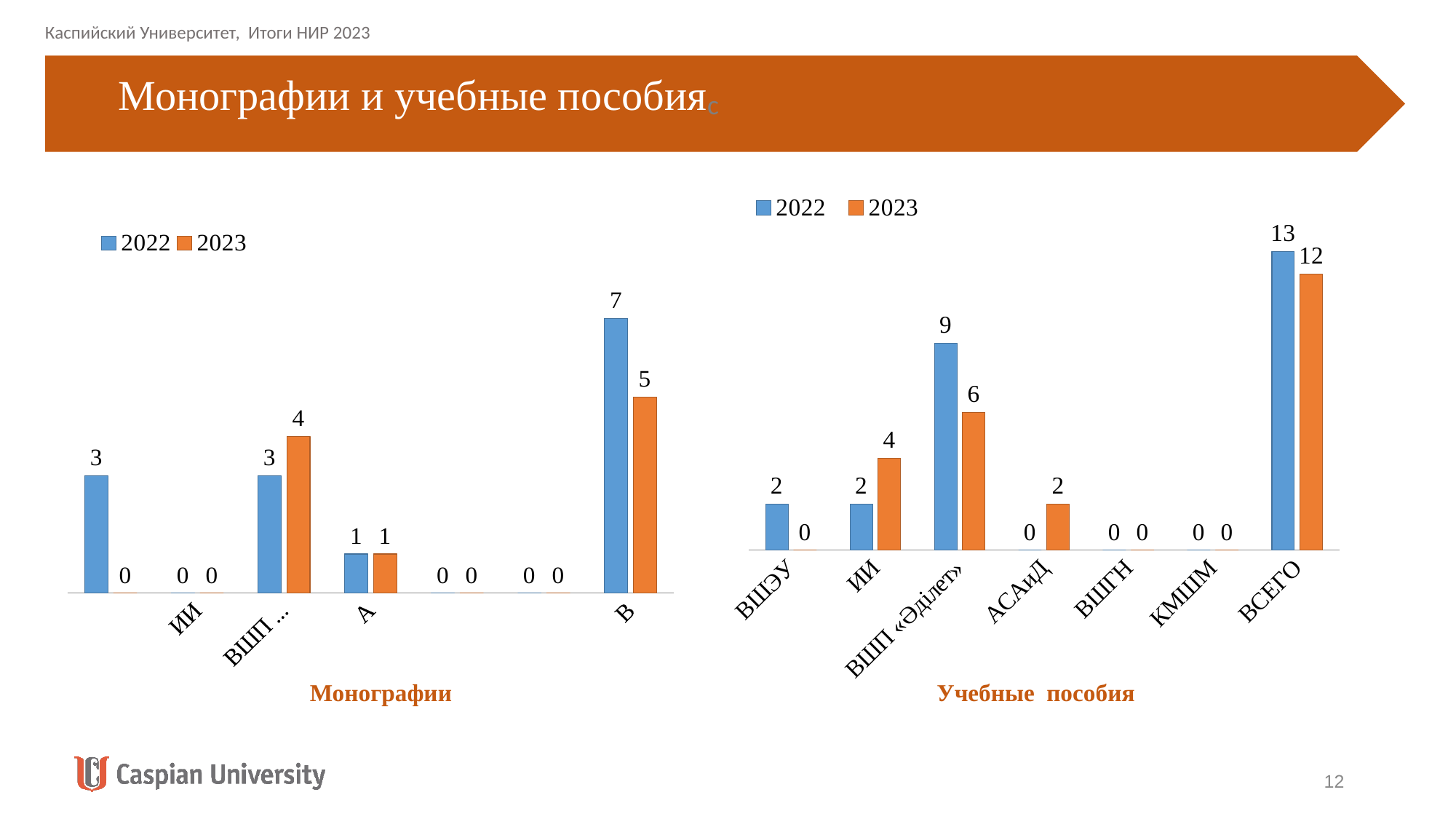
In the Учебные пособия chart, what is the value for ВШП «Әділет» in 2023? 6 What kind of chart is the Монографии chart? bar chart In the Учебные пособия chart, which is larger for ВШЭУ: the 2022 value or the 2023 value? 2022 In the Учебные пособия chart, what is the value for АСАиД in 2022? 0 In the Монографии chart, what is the 2023 value for the category labelled ВШП ...? 4 In the Учебные пособия chart, what is the difference between the 2022 and 2023 values for ВШП «Әділет»? 3 In the Учебные пособия chart, what is the value for ВСЕГО in 2022? 13 How many categories are shown on the x axis of the Учебные пособия chart? 7 In the Учебные пособия chart, what is the value for ИИ in 2023? 4 In the Учебные пособия chart, which category has the highest 2022 value? ВСЕГО In the Монографии chart, what is the difference between the 2022 and 2023 values for the category labelled В? 2 How many series does the legend of the Монографии chart list? 2